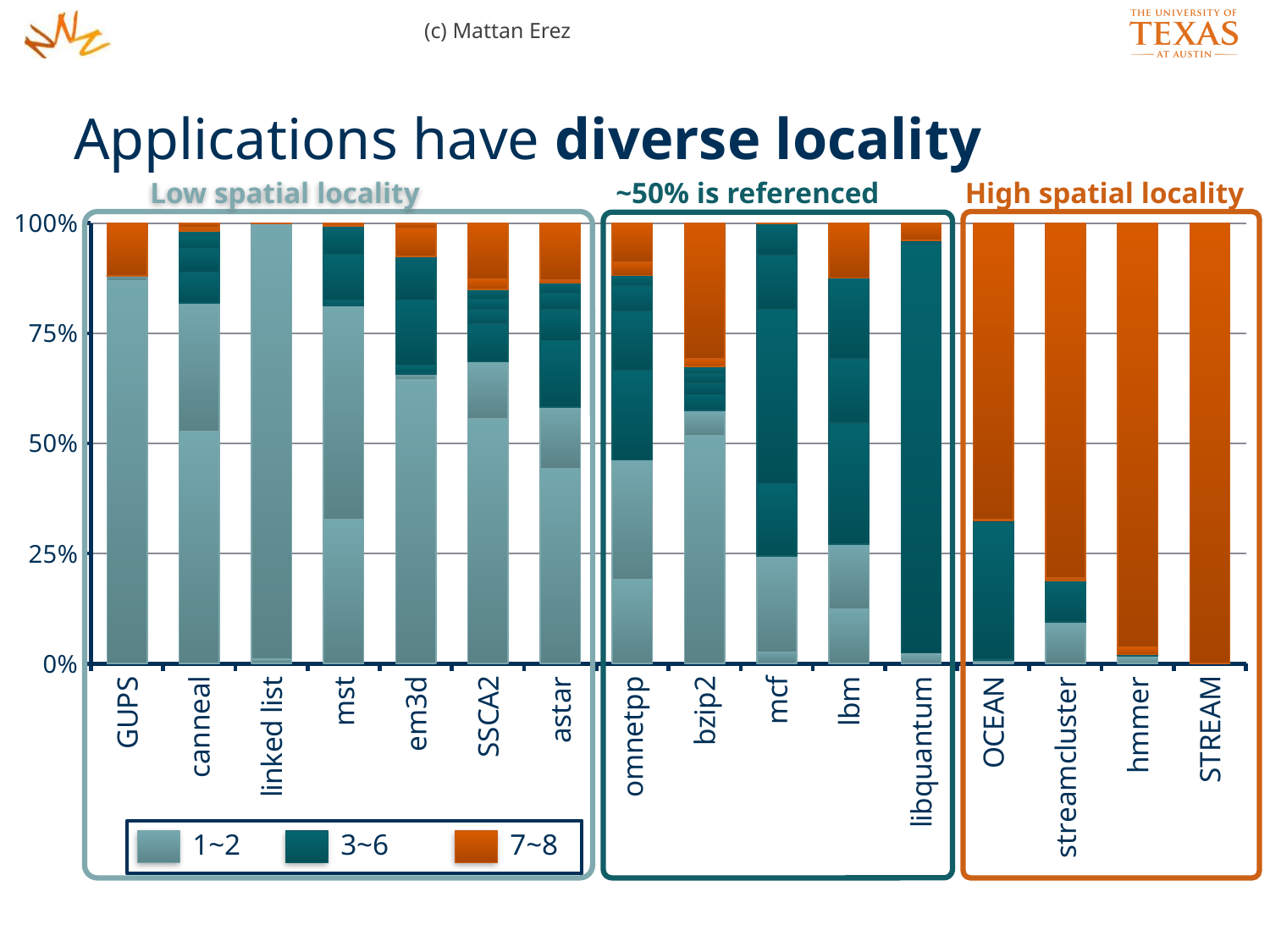
Is the 1~2 share for GUPS greater or less than 75%? greater Which has the larger 1~2 share, GUPS or canneal? GUPS Which application has the largest 7~8 share? STREAM How many series does the legend list? 3 Which application has the largest 1~2 share? linked list What kind of chart is shown on the slide? stacked bar chart Is the 7~8 share for OCEAN greater or less than 50%? greater What is the label of the group box on the right side of the chart? High spatial locality Which application has the largest 3~6 share? libquantum What are the three series named in the legend? 1~2, 3~6, 7~8 Is the 1~2 share for mst greater or less than 50%? greater How many applications (categories) are plotted along the x axis? 16